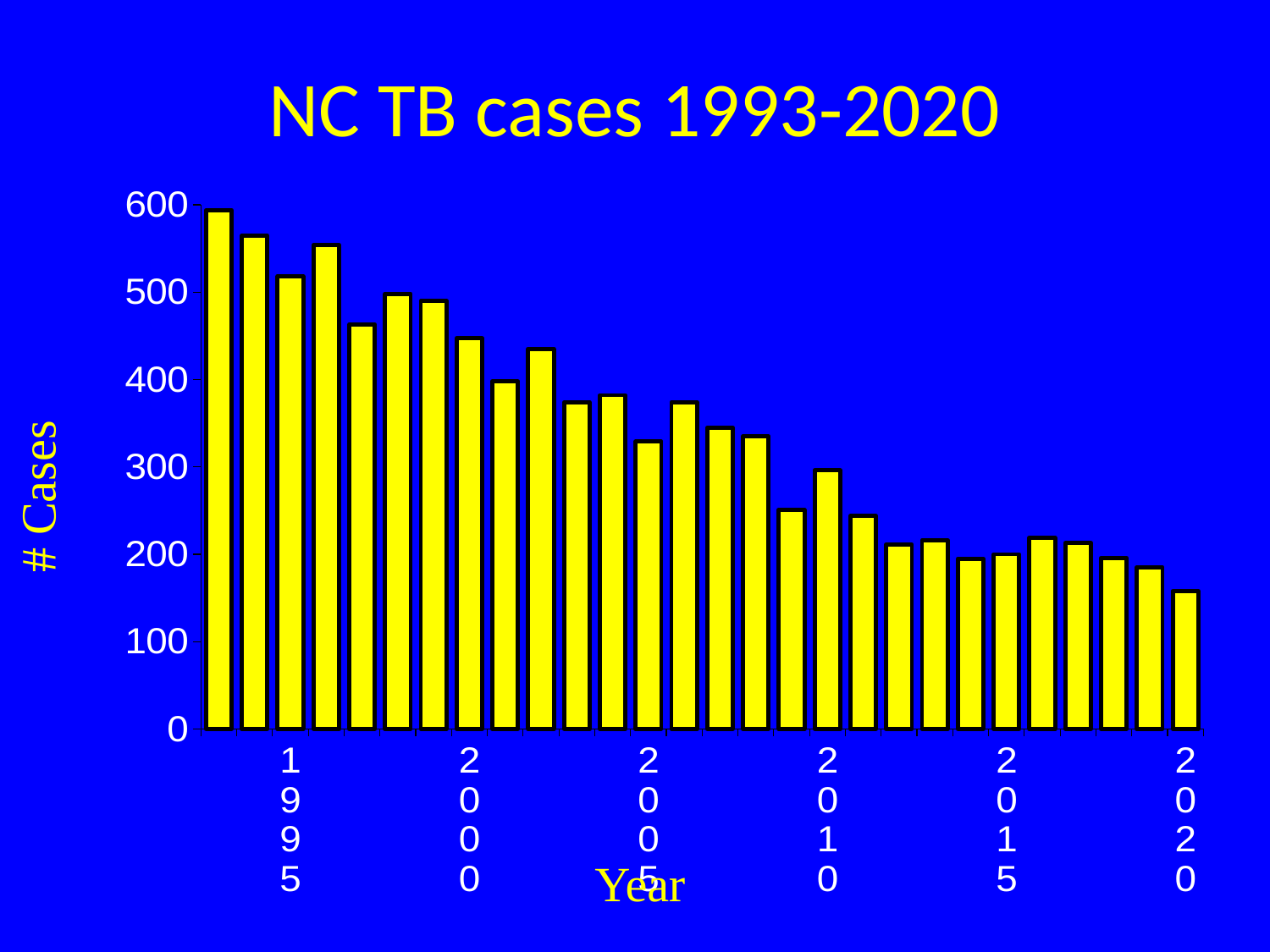
What is the title of the chart? NC TB cases 1993-2020 Which year has more TB cases, 2000 or 2010? 2000 How many bars (years) are plotted in the chart? 28 Is the value for 2020 greater or less than 200? less Is the value for 2015 greater or less than 300? less Is the value for 2000 greater or less than 400? greater Which year has the highest number of TB cases? 1993 What kind of chart is shown on the slide? bar chart Which year has the lowest number of TB cases? 2020 Overall, do the number of TB cases rise or fall from 1993 to 2020? fall What is the label on the vertical axis of the chart? # Cases